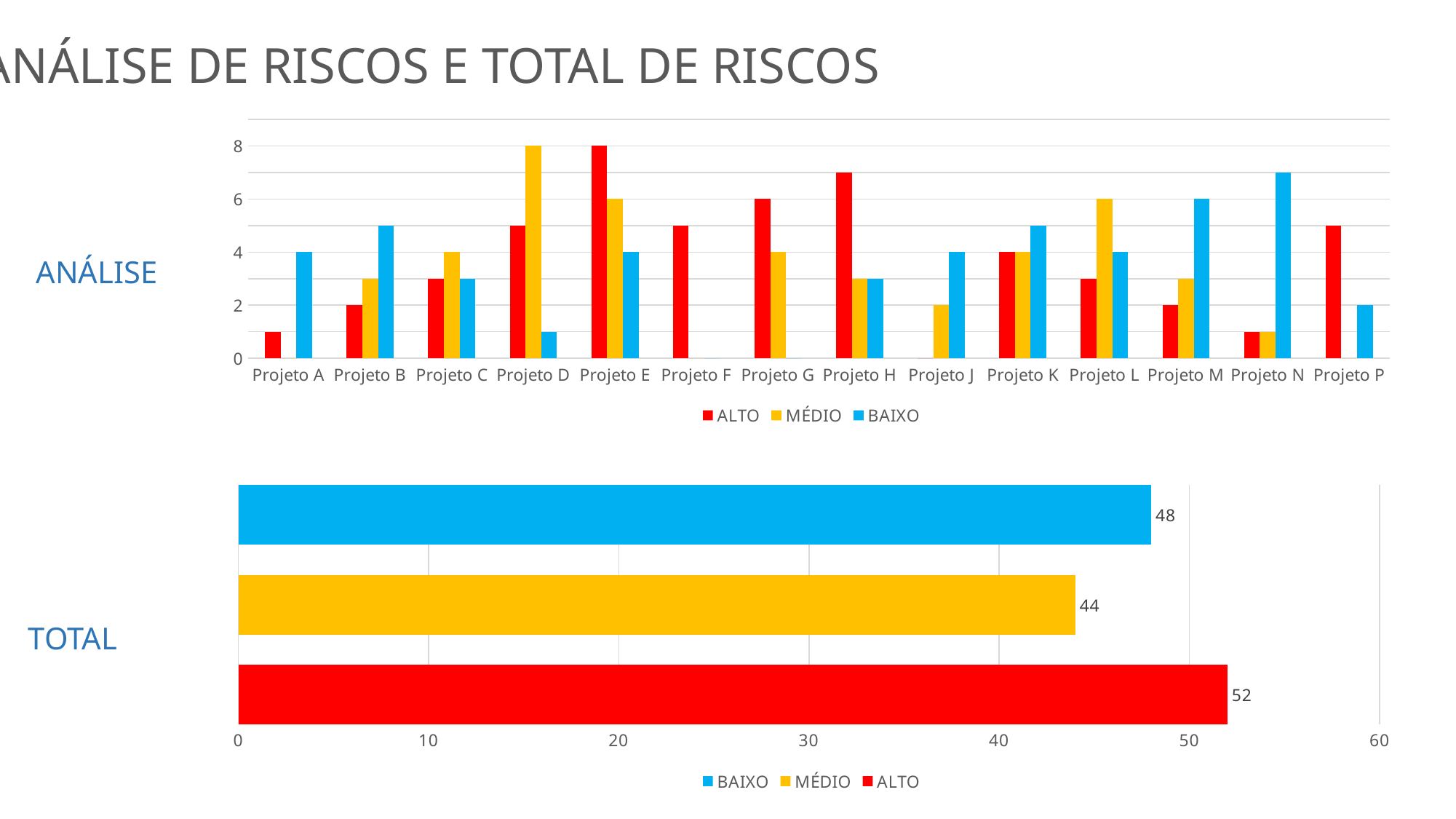
In the TOTAL chart at the bottom, which is larger, BAIXO or MÉDIO? BAIXO What kind of chart is the TOTAL chart at the bottom? Bar chart In the ANÁLISE chart at the top, how many projects are shown on the x axis? 14 In the ANÁLISE chart at the top, what is the ALTO value for Projeto E? 8 In the TOTAL chart at the bottom, which category has the lowest value? MÉDIO In the TOTAL chart at the bottom, what is the value for ALTO? 52 In the ANÁLISE chart at the top, what is the MÉDIO value for Projeto D? 8 In the TOTAL chart at the bottom, what is the value for MÉDIO? 44 In the ANÁLISE chart at the top, is the BAIXO value for Projeto N greater or less than 6? greater In the TOTAL chart at the bottom, what is the difference between the ALTO and BAIXO values? 4 In the TOTAL chart at the bottom, which category has the highest value? ALTO In the ANÁLISE chart at the top, how many series does the legend list? 3